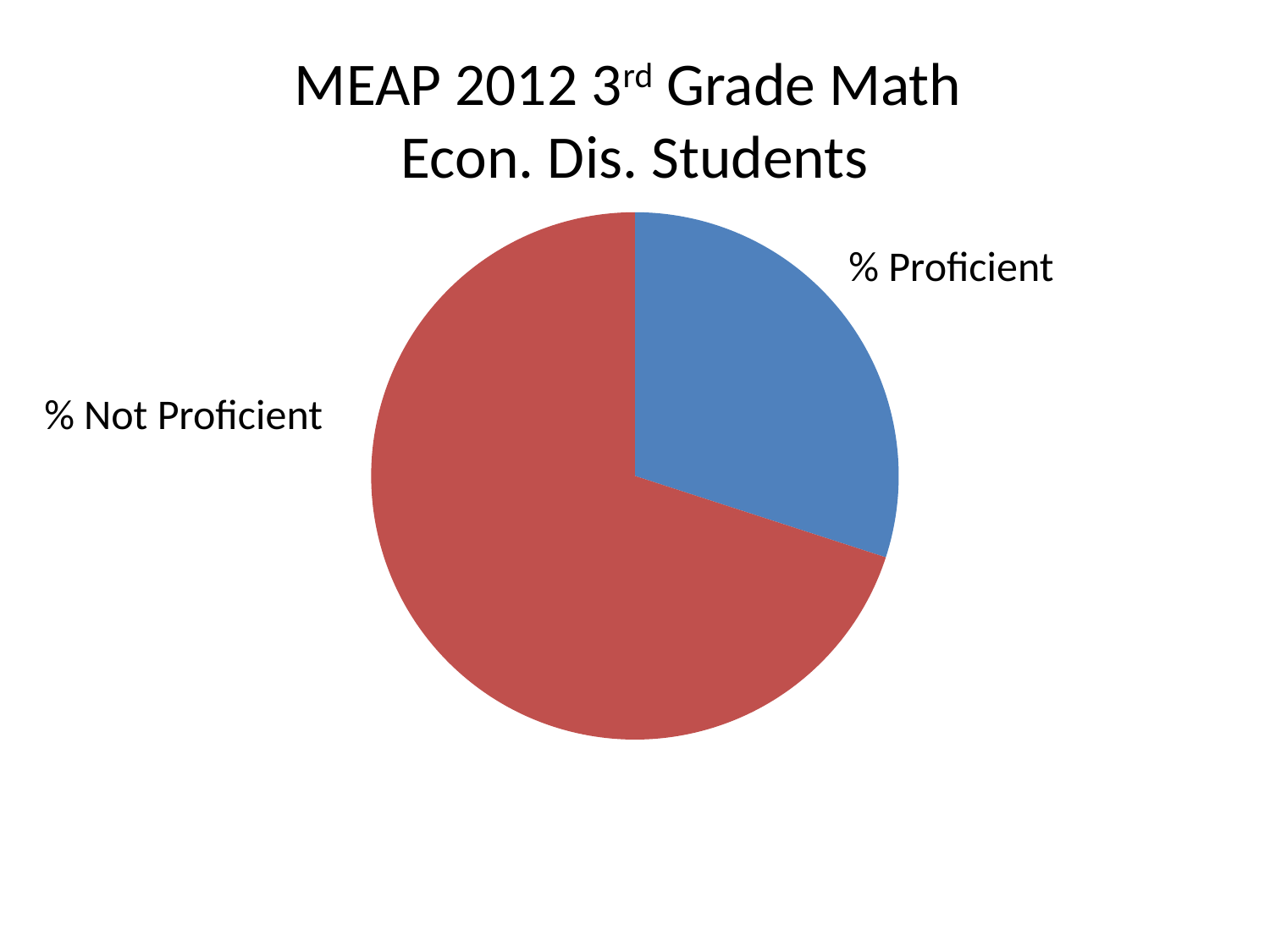
Which slice of the pie chart is the smallest? % Proficient Which slice of the pie chart is the largest? % Not Proficient How many slices does the pie chart have? 2 What colour is the % Not Proficient slice? red Does the % Proficient slice take up more or less than half of the pie? less Which is larger in the pie chart, % Proficient or % Not Proficient? % Not Proficient What is the title of the chart? MEAP 2012 3rd Grade Math Econ. Dis. Students What kind of chart is shown on the slide? pie chart